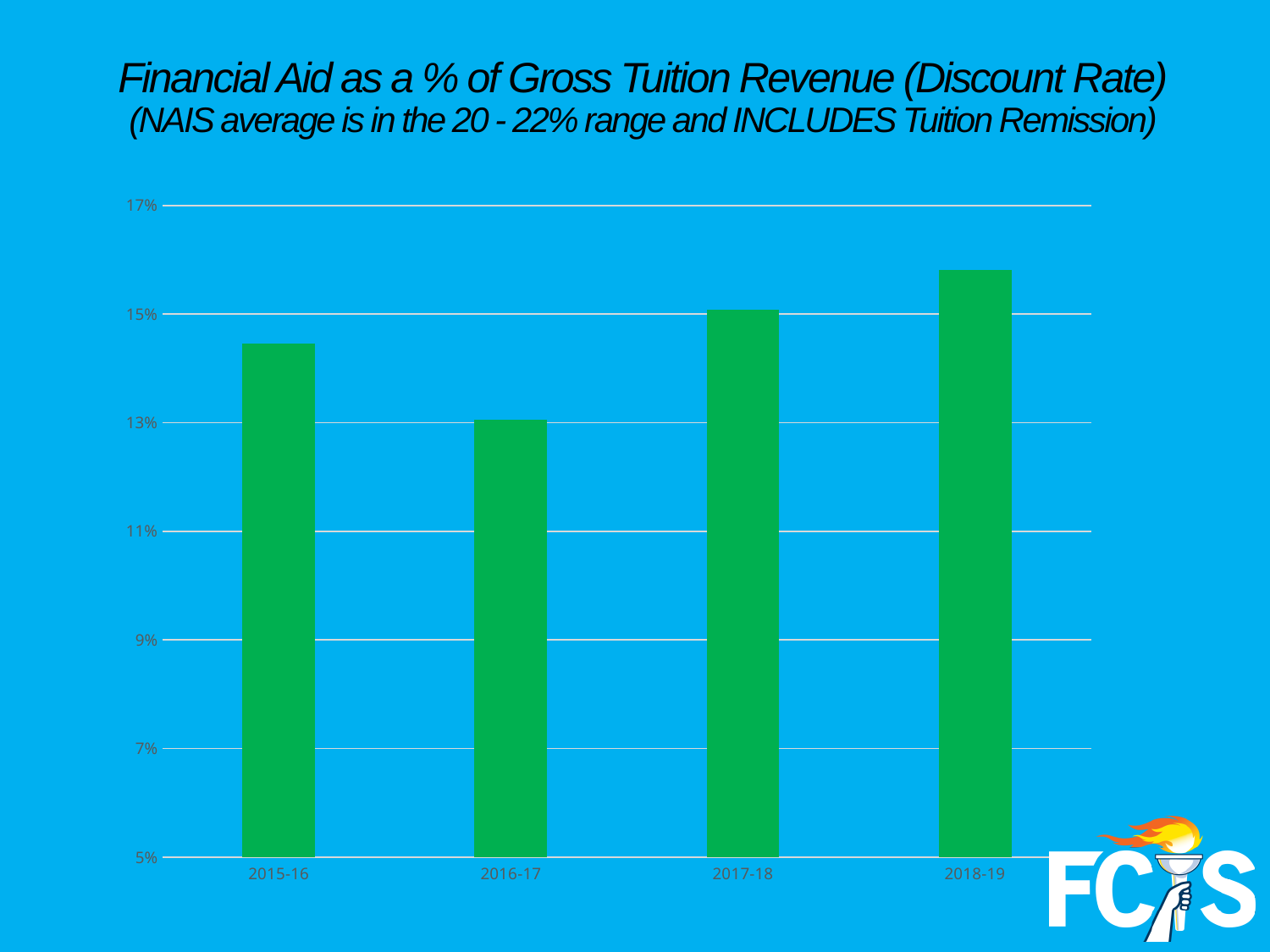
What kind of chart is shown on the slide? bar chart Which school year has the lowest financial aid discount rate? 2016-17 Do the values rise or fall from 2016-17 through 2018-19? rise How many school years are shown on the x axis of the chart? 4 Which is larger, the value for 2018-19 or the value for 2015-16? 2018-19 What is the title of the chart? Financial Aid as a % of Gross Tuition Revenue (Discount Rate) Which is larger, the value for 2015-16 or the value for 2016-17? 2015-16 Which school year has the highest financial aid discount rate? 2018-19 Is the value for 2016-17 greater or less than 15%? less Is the value for 2018-19 greater or less than 15%? greater Is the value for 2015-16 greater or less than 15%? less